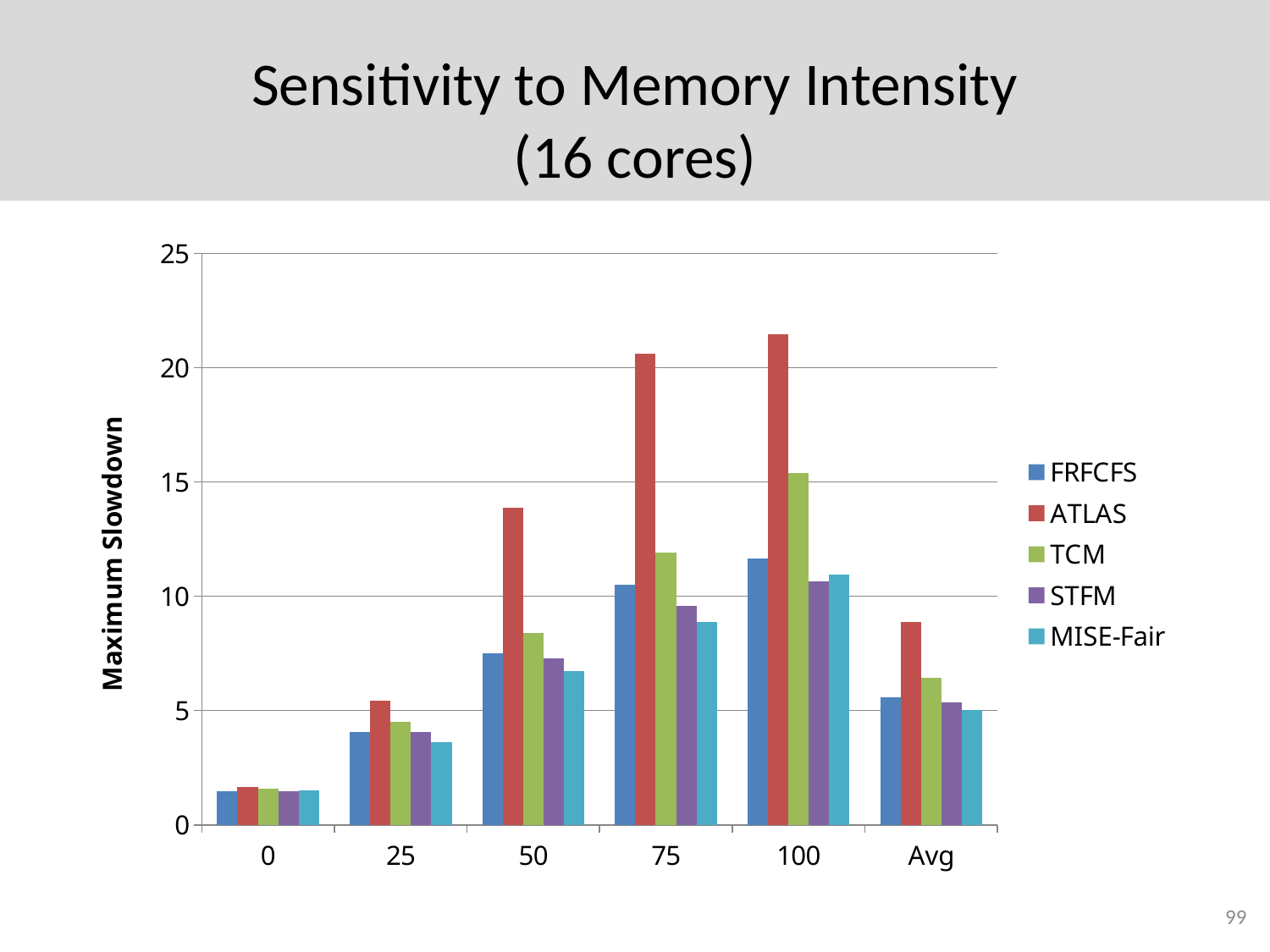
What is the label on the y axis? Maximum Slowdown Is the ATLAS value at 50 greater or less than 15? less What kind of chart is shown on the slide? bar chart At 50, which is larger: the ATLAS bar or the TCM bar? ATLAS How many categories are shown along the x axis? 6 At 100, which is larger: the TCM bar or the FRFCFS bar? TCM Do the ATLAS values rise or fall as the x axis goes from 0 to 100? rise How many series does the legend list? 5 For which x-axis category is the ATLAS bar the highest? 100 For which x-axis category is the ATLAS bar the lowest? 0 Is the ATLAS value at 75 greater or less than 20? greater Is the MISE-Fair value at 75 greater or less than 10? less